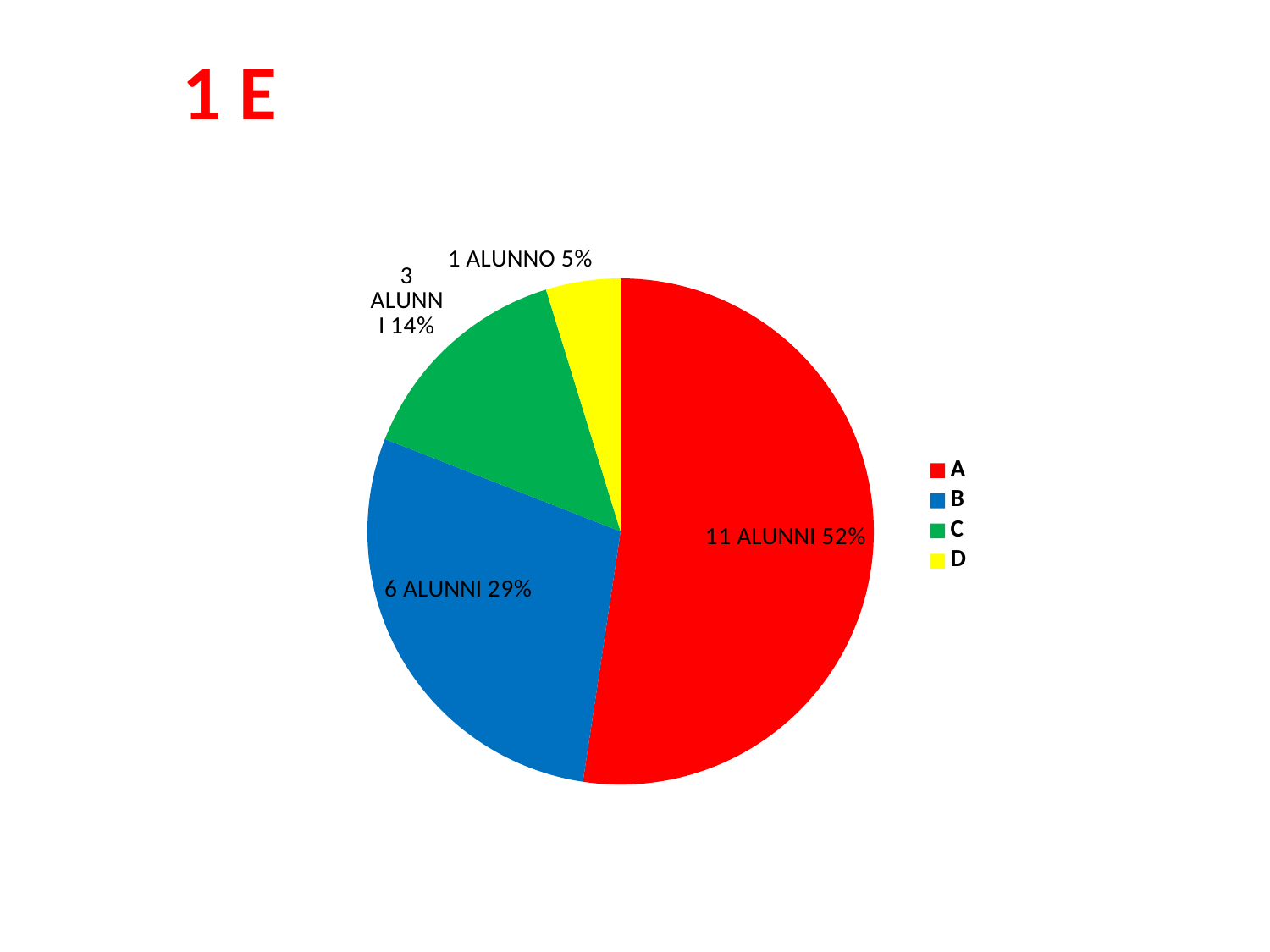
Which category has the smallest slice? D What percentage share does category C have? 14% What is the difference in number of students between category A and category B? 5 How many students (alunni) are in category A? 11 What kind of chart is shown on the slide? pie chart What percentage share does category A have? 52% What percentage share does category D have? 5% Which category has the largest slice? A How many categories does the legend list? 4 How many students (alunni) are in category B? 6 Which category has a larger share, B or C? B